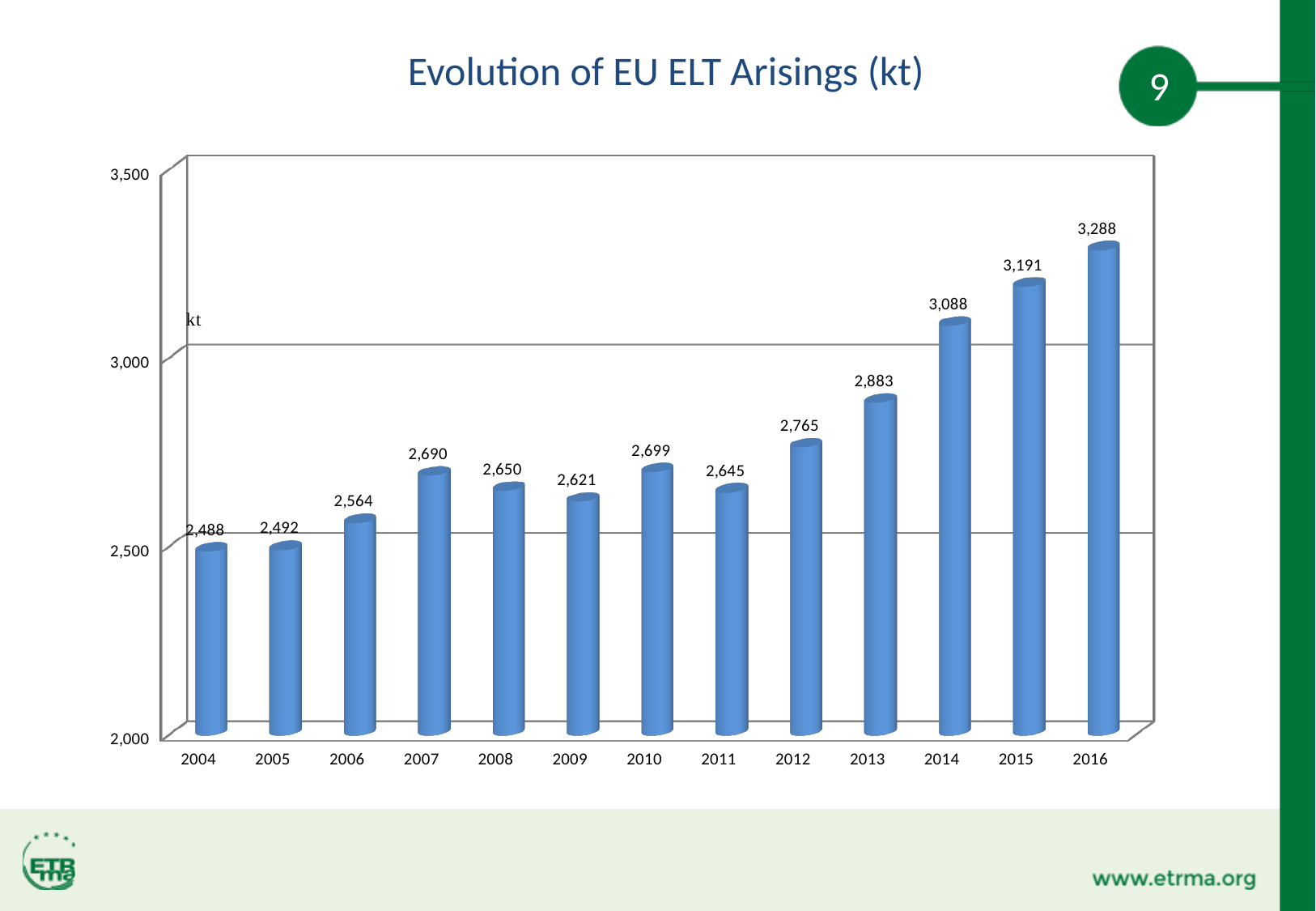
What is the difference between the values for 2016 and 2015? 97 What is the title of the chart? Evolution of EU ELT Arisings (kt) Which year has the lowest value? 2004 What is the value for 2010? 2,699 What kind of chart is this? bar chart Which is larger, the value for 2007 or the value for 2008? 2007 What is the value for 2004? 2,488 Which year has the highest value? 2016 What is the value for 2016? 3,288 What is the difference between the values for 2014 and 2013? 205 Is the value for 2013 greater or less than 3,000? less How many years are shown on the x axis? 13